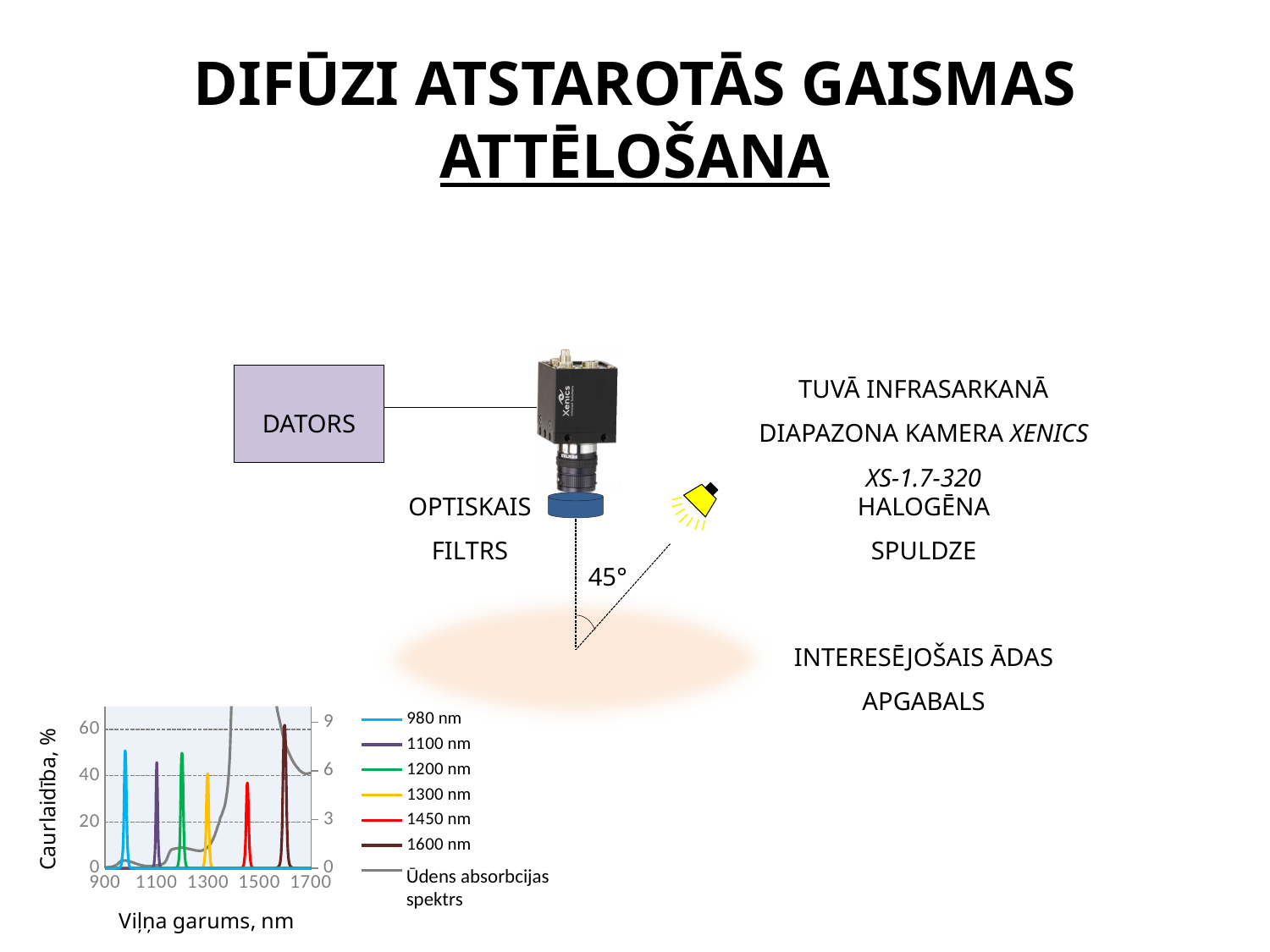
Which has a higher peak in the chart, the 980 nm series or the 1450 nm series? 980 nm Which has a higher peak in the chart, the 1600 nm series or the 1450 nm series? 1600 nm What kind of chart is shown at the bottom left of the slide? line chart Is the peak value of the 1600 nm series greater or less than 40? greater How many entries does the legend of the chart list? 7 What is the title of the left y axis of the chart? Caurlaidība, % How many filter peaks (excluding the water absorption spectrum) are plotted in the chart? 6 Which filter series has the highest peak transmission in the chart? 1600 nm Is the peak value of the 980 nm series greater or less than 40? greater What is the title of the x axis of the chart? Viļņa garums, nm Is the peak value of the 1450 nm series greater or less than 40? less Which filter series has the lowest peak transmission in the chart? 1450 nm